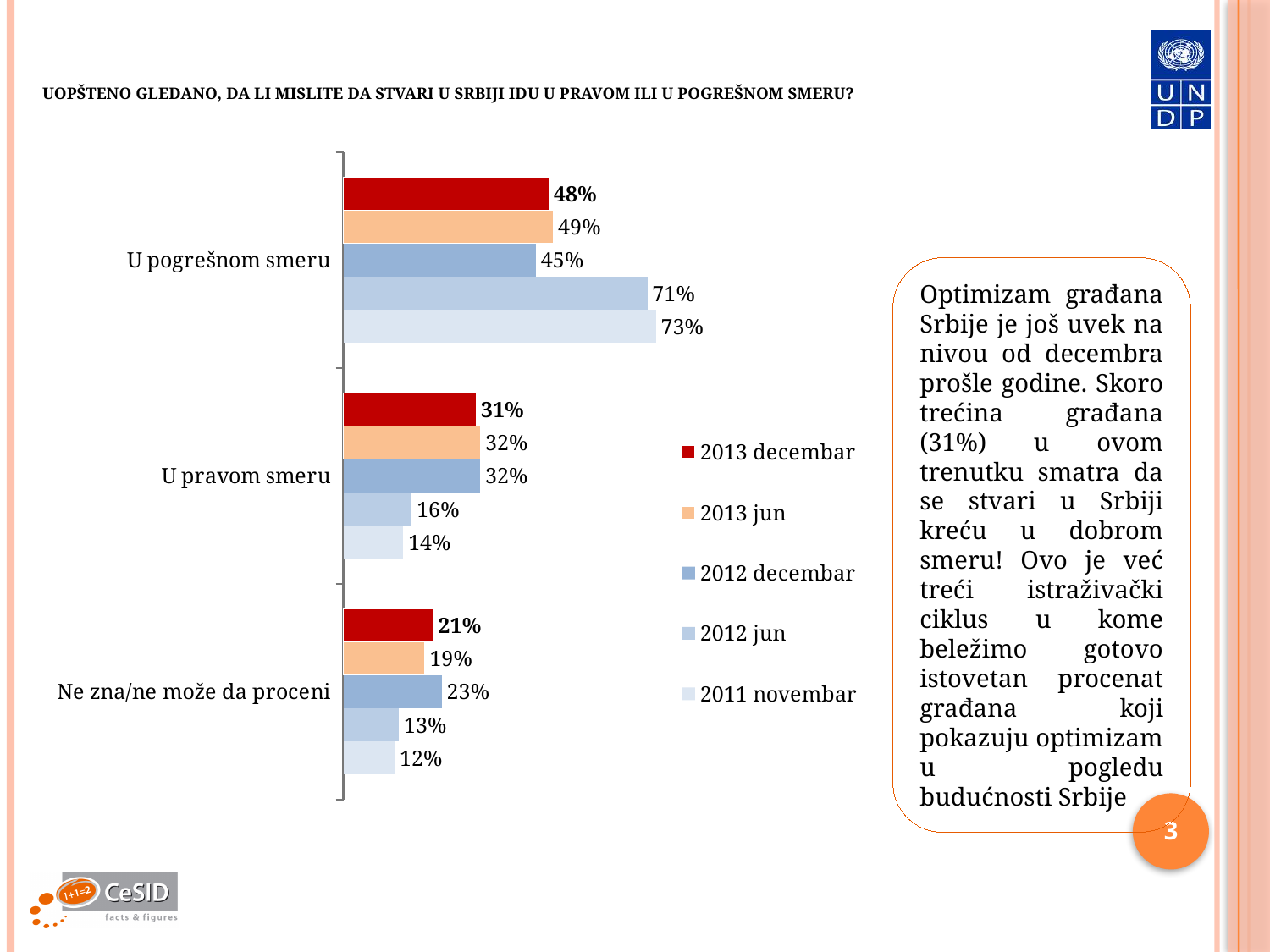
What is the value for 'Ne zna/ne može da proceni' in the 2012 decembar series? 23% What is the value for 'U pogrešnom smeru' in the 2013 decembar series? 48% What kind of chart is shown on the slide? Bar chart What is the value for 'U pogrešnom smeru' in the 2012 jun series? 71% How many series does the legend list? 5 What is the difference between the 2011 novembar and 2013 decembar values for 'U pogrešnom smeru'? 25% Which category has the highest value in the 2013 decembar series? U pogrešnom smeru How many categories are shown on the chart? 3 What is the value for 'U pravom smeru' in the 2011 novembar series? 14% Which category has the lowest value in the 2011 novembar series? Ne zna/ne može da proceni Which series is shown in red in the legend? 2013 decembar Which is larger for 'U pravom smeru': the 2013 jun value or the 2012 jun value? 2013 jun